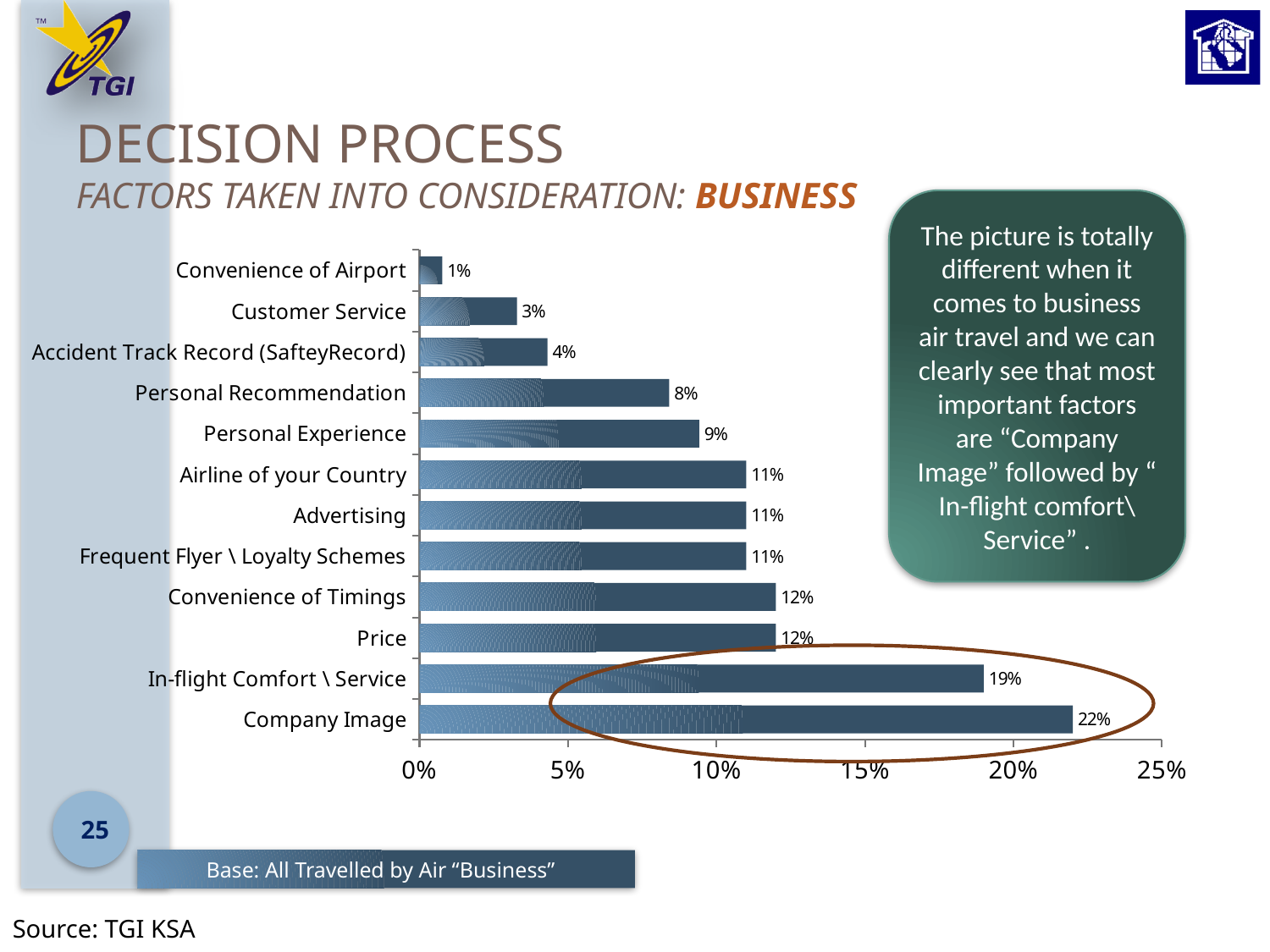
Is the value for Price greater or less than 10%? greater What is the value for In-flight Comfort \ Service? 19% What is the value for Personal Recommendation? 8% How many categories are shown in the chart? 12 What is the base stated below the chart? All Travelled by Air "Business" What is the value for Convenience of Airport? 1% What is the value for Company Image? 22% Which is larger, the value for Personal Experience or the value for Customer Service? Personal Experience Which category has the lowest value? Convenience of Airport Which category has the highest value? Company Image What is the difference between the values for Company Image and In-flight Comfort \ Service? 3% What kind of chart is shown on the slide? bar chart